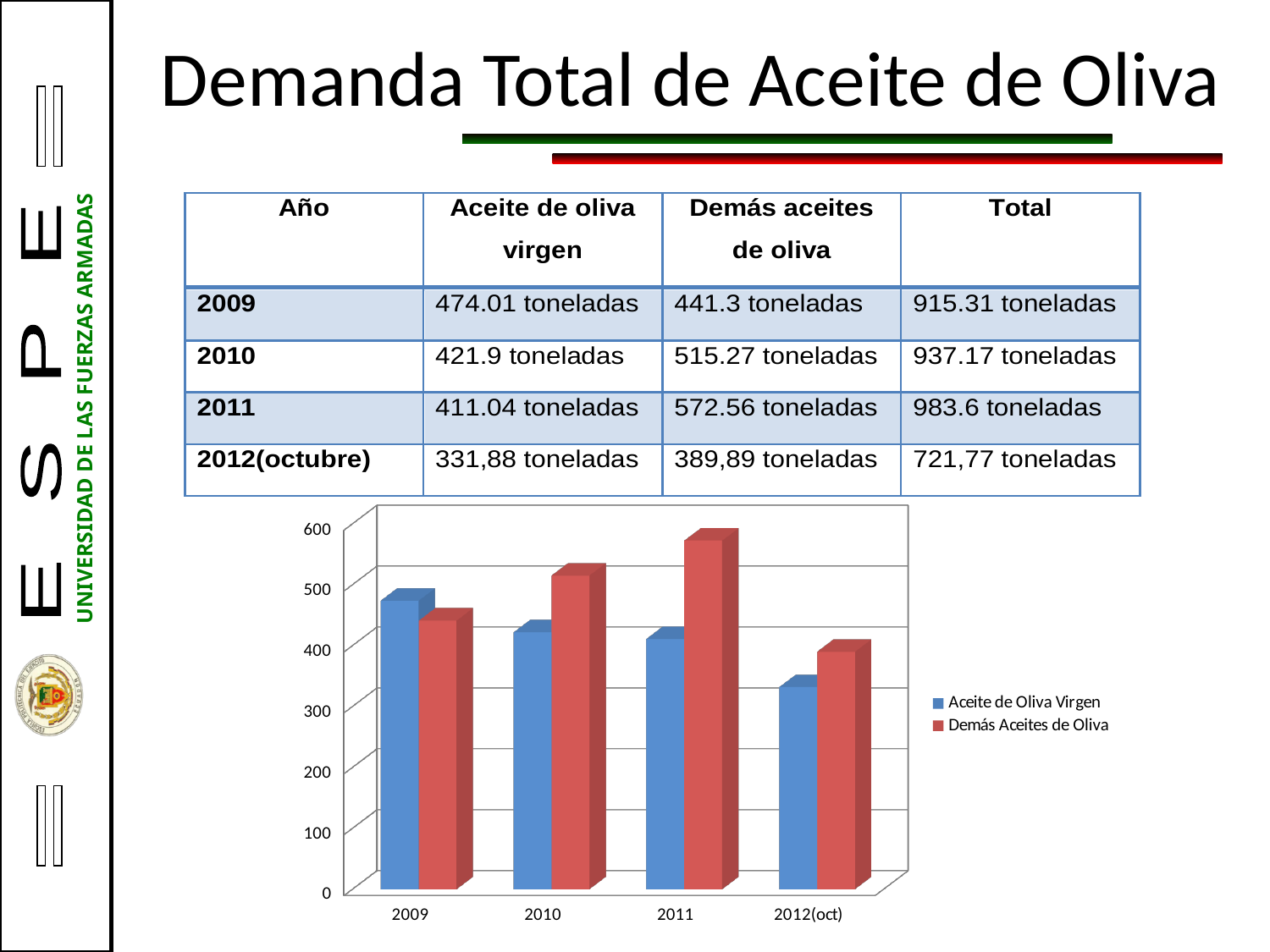
In which year is the value for Aceite de Oliva Virgen lowest? 2012(oct) Is the value for Demás Aceites de Oliva in 2011 greater or less than 500? greater Does the value for Aceite de Oliva Virgen rise or fall from 2009 to 2012(oct)? fall In 2009, which is larger: Aceite de Oliva Virgen or Demás Aceites de Oliva? Aceite de Oliva Virgen Which colour represents Demás Aceites de Oliva in the chart? red According to the table, what is the value for Aceite de oliva virgen in 2010? 421.9 toneladas How many series does the chart's legend list? 2 According to the table, what is the difference between Demás aceites de oliva and Aceite de oliva virgen in 2011? 161.52 toneladas In which year is the value for Demás Aceites de Oliva highest? 2011 Is the value for Aceite de Oliva Virgen in 2012(oct) greater or less than 400? less How many year categories are shown on the x axis of the chart? 4 What kind of chart is shown on the slide? bar chart